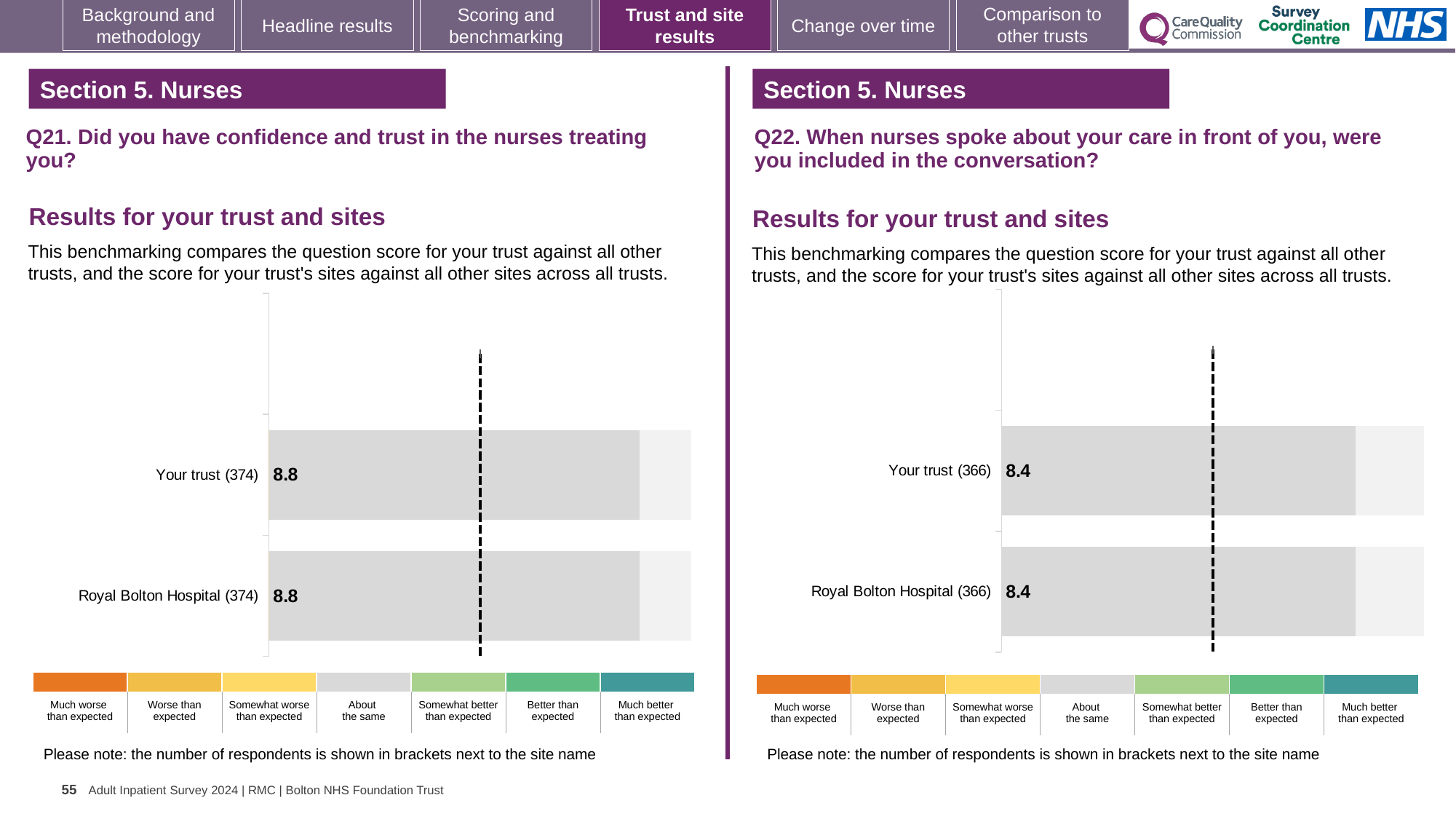
In the Q21 chart on the left, what is the difference between the score for Your trust and the score for Royal Bolton Hospital? 0 In the Q21 chart on the left, what is the score for Your trust? 8.8 What type of chart is used in the Q21 chart on the left? bar chart Is the Your trust score in the Q21 chart on the left larger or smaller than the Your trust score in the Q22 chart on the right? larger In the Q21 chart on the left, which benchmark category does the colour key label with the darkest teal colour at the far right? Much better than expected How many bars are plotted in the Q22 chart on the right? 2 In the Q22 chart on the right, how many respondents are shown in brackets for Royal Bolton Hospital? 366 In the Q21 chart on the left, how many respondents are shown in brackets for Your trust? 374 How many benchmark categories are listed in the colour key below the Q22 chart on the right? 7 In the Q21 chart on the left, what is the score for Royal Bolton Hospital? 8.8 In the Q22 chart on the right, what is the score for Your trust? 8.4 In the Q22 chart on the right, what is the score for Royal Bolton Hospital? 8.4